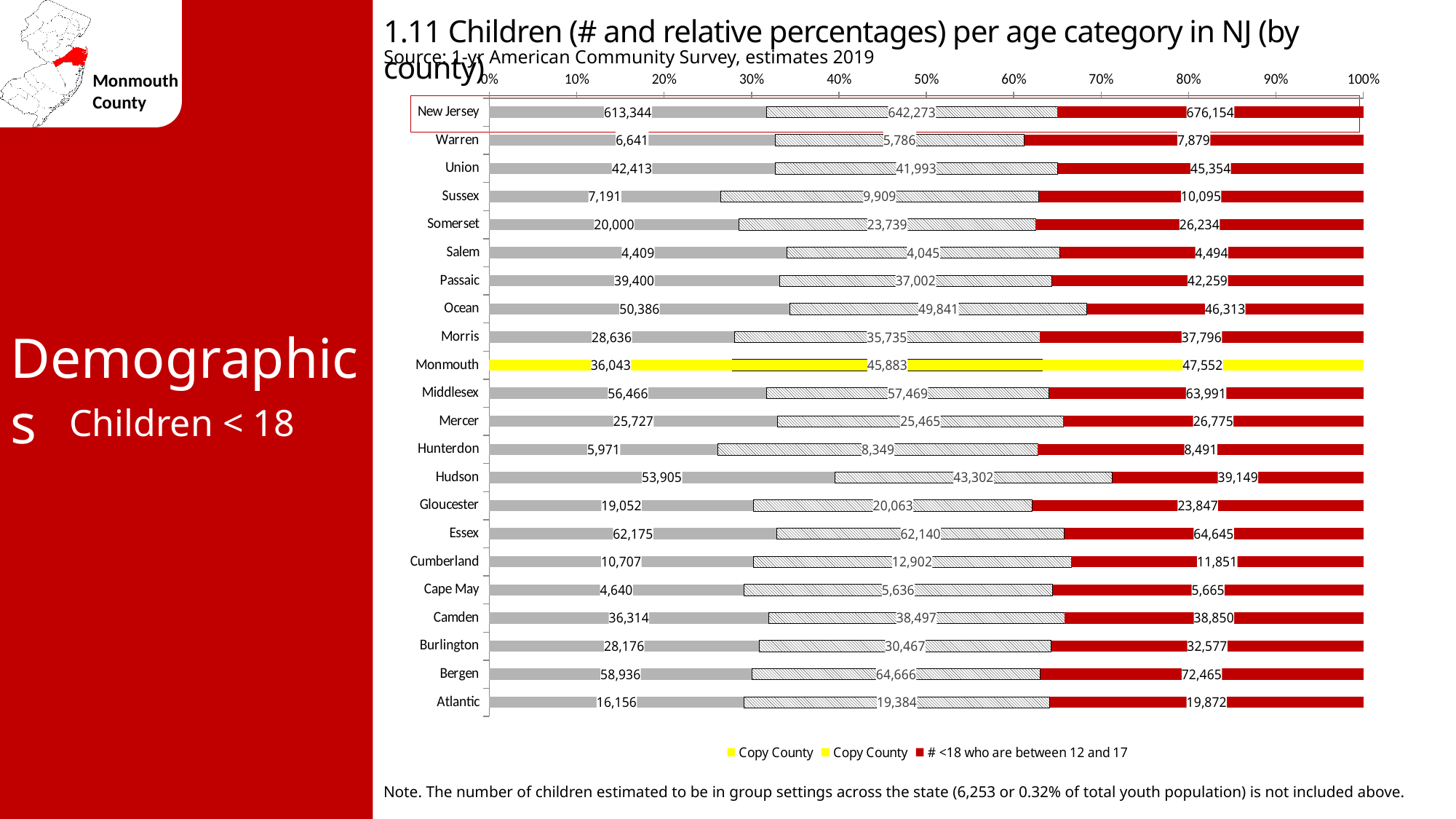
How many series does the legend list? 3 What kind of chart is shown on the slide? Stacked bar chart Among the counties (excluding the New Jersey row), which has the smallest value in the red segment (# <18 who are between 12 and 17)? Salem What is the value of the red segment (# <18 who are between 12 and 17) for New Jersey? 676,154 Is the share of the first segment for Hudson greater or less than 30%? greater What is the value of the first (leftmost) segment for Hudson? 53,905 What is the total of the three segments for Monmouth? 129,478 Which is larger for Hudson: the first segment value or the red segment value? The first segment (53,905) What is the value of the red segment (# <18 who are between 12 and 17) for Monmouth? 47,552 What is the difference between the red segment value and the first segment value for Monmouth? 11,509 Among the counties (excluding the New Jersey row), which has the largest value in the red segment (# <18 who are between 12 and 17)? Bergen How many categories (rows) are plotted in the chart? 22